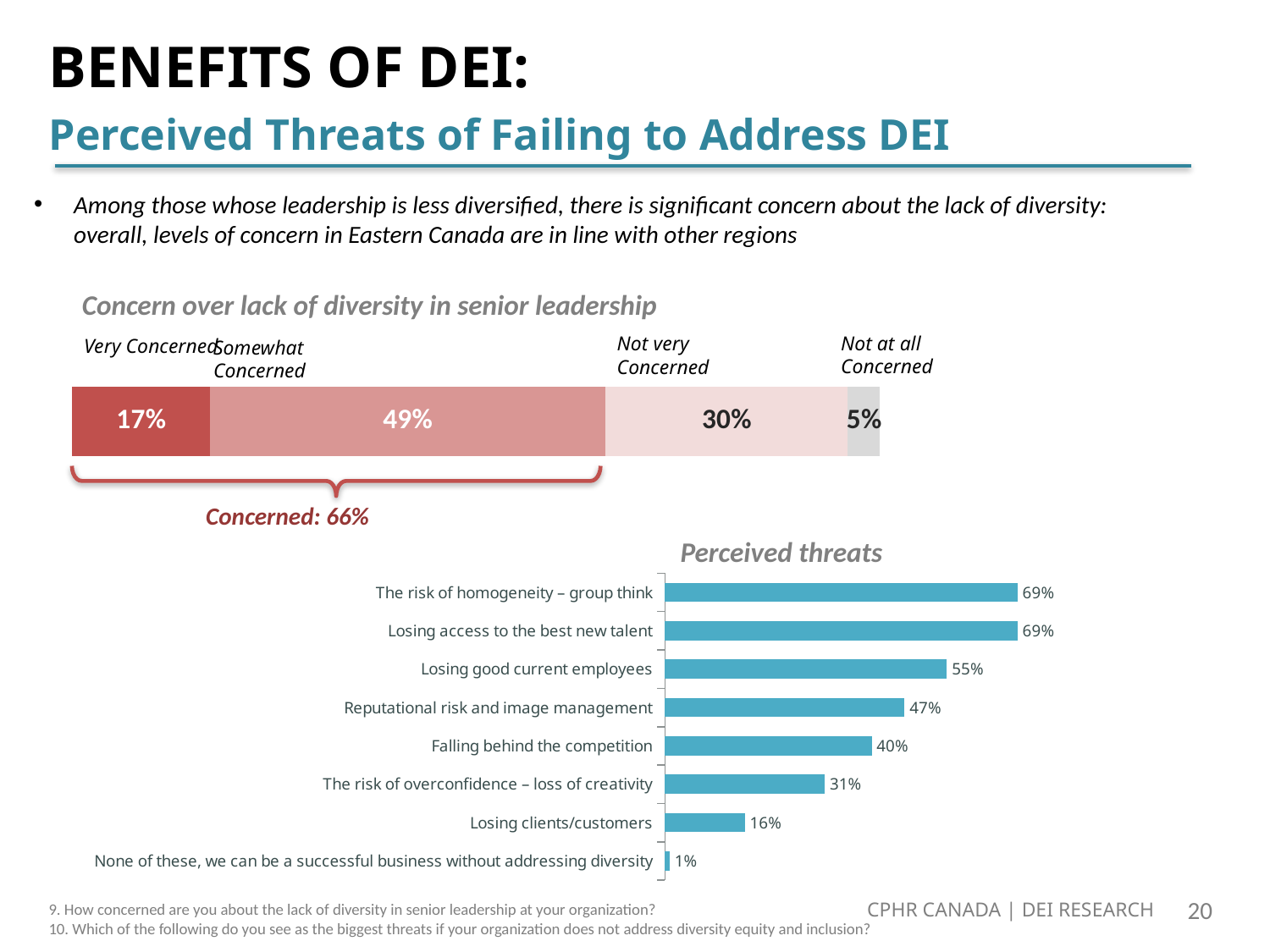
In the 'Perceived threats' chart, which is larger: The risk of overconfidence – loss of creativity or Losing clients/customers? The risk of overconfidence – loss of creativity In the 'Concern over lack of diversity in senior leadership' chart, what percentage is Not very Concerned? 30% In the 'Perceived threats' chart, which category has the lowest value? None of these, we can be a successful business without addressing diversity How many categories are shown in the 'Perceived threats' chart? 8 In the 'Perceived threats' chart, what percentage is shown for Losing good current employees? 55% In the 'Concern over lack of diversity in senior leadership' chart, what percentage is Somewhat Concerned? 49% In the 'Perceived threats' chart, what is the difference between Reputational risk and image management and Losing clients/customers? 31% In the 'Concern over lack of diversity in senior leadership' chart, what is the combined total of Very Concerned and Somewhat Concerned? 66% In the 'Perceived threats' chart, what percentage is shown for Falling behind the competition? 40% In the 'Concern over lack of diversity in senior leadership' chart, what percentage is Very Concerned? 17% In the 'Concern over lack of diversity in senior leadership' chart, which category has the smallest share? Not at all Concerned What type of chart is the 'Perceived threats' chart? Bar chart